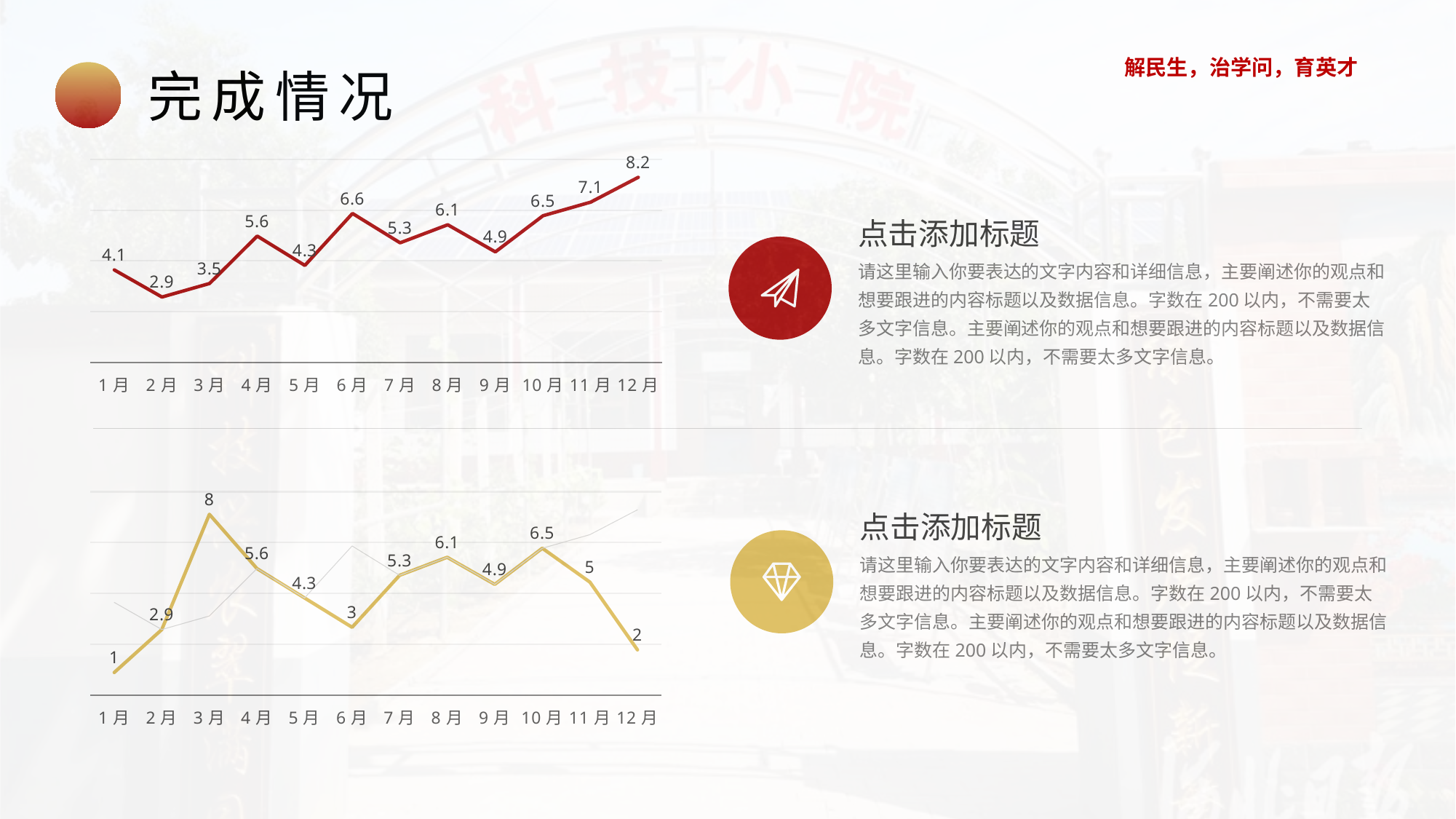
In the top chart, what is the difference between the values for 12月 and 1月? 4.1 In the top chart, what is the value for 12月? 8.2 In the top chart, which month has the highest value? 12月 In the bottom chart, which month has the highest value on the gold line? 3月 In the top chart, which is larger, the value for 6月 or the value for 7月? 6月 In the bottom chart, what is the value for 3月? 8 In the bottom chart, which month has the lowest value on the gold line? 1月 How many months are plotted along the x axis of the top chart? 12 What type of chart is the top chart? Line chart In the top chart, which month has the lowest value? 2月 In the top chart, what is the value for 2月? 2.9 In the bottom chart, what is the difference between the values for 10月 and 11月 on the gold line? 1.5